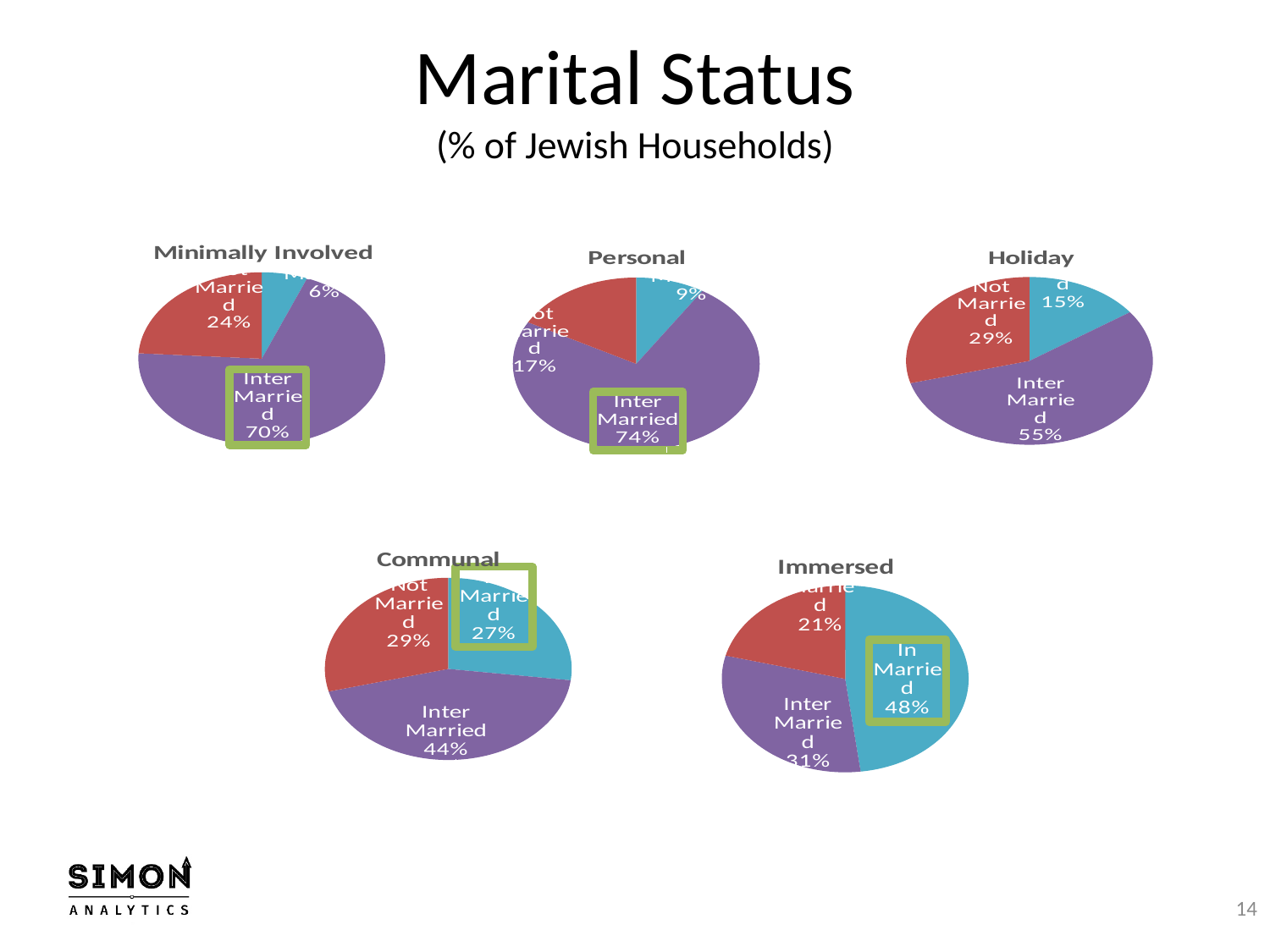
In the Personal chart, what percentage is Inter Married? 74% What is the title of the chart in the bottom right of the slide? Immersed In the Holiday chart, what percentage is Not Married? 29% In the Immersed chart, what percentage is In Married? 48% In the Communal chart, what percentage is Inter Married? 44% How many pie charts are shown on the slide? 5 In the Holiday chart, which category has the largest share? Inter Married What is the difference between the Inter Married share in the Personal chart and the Inter Married share in the Holiday chart? 19% What type of chart is used for the Holiday data? Pie chart In the Immersed chart, which category has the smallest share? Not Married In the Minimally Involved chart, what percentage is Inter Married? 70% Which is larger: the Inter Married share in the Communal chart or the Inter Married share in the Immersed chart? Communal